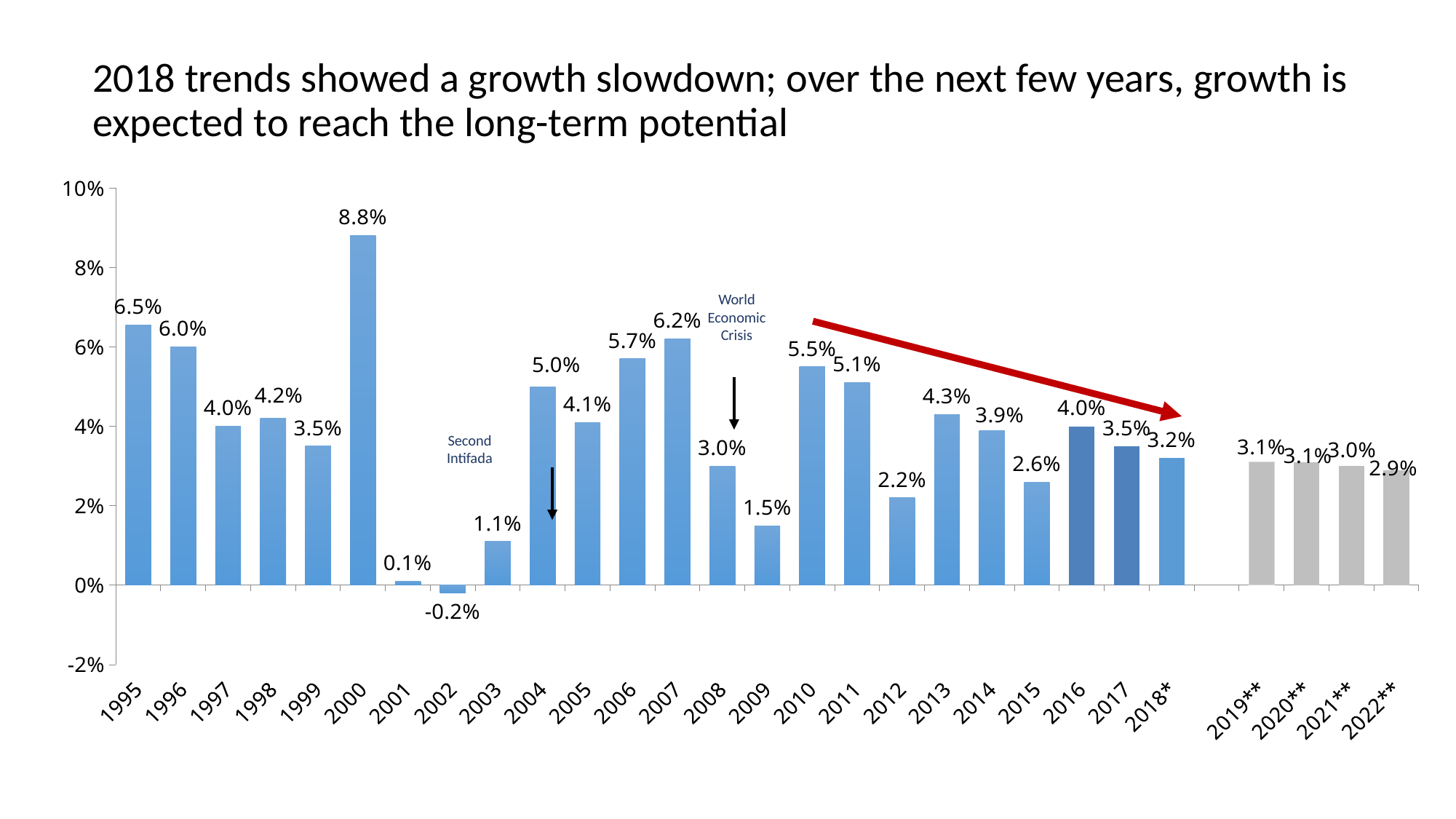
What kind of chart is this? bar chart Which year has the lowest value? 2002 Is the value for 2006 greater or less than 4%? greater What is the difference between the values for 2007 and 2008? 3.2% What is the value for 2000? 8.8% How many years are shown on the x axis? 28 Which year has the highest value? 2000 Do the values rise or fall from 2010 to 2018*? fall What is the value for 2022**? 2.9% What is the value for 2018*? 3.2% What is the value for 2002? -0.2% Which is larger, the value for 2010 or the value for 2011? 2010